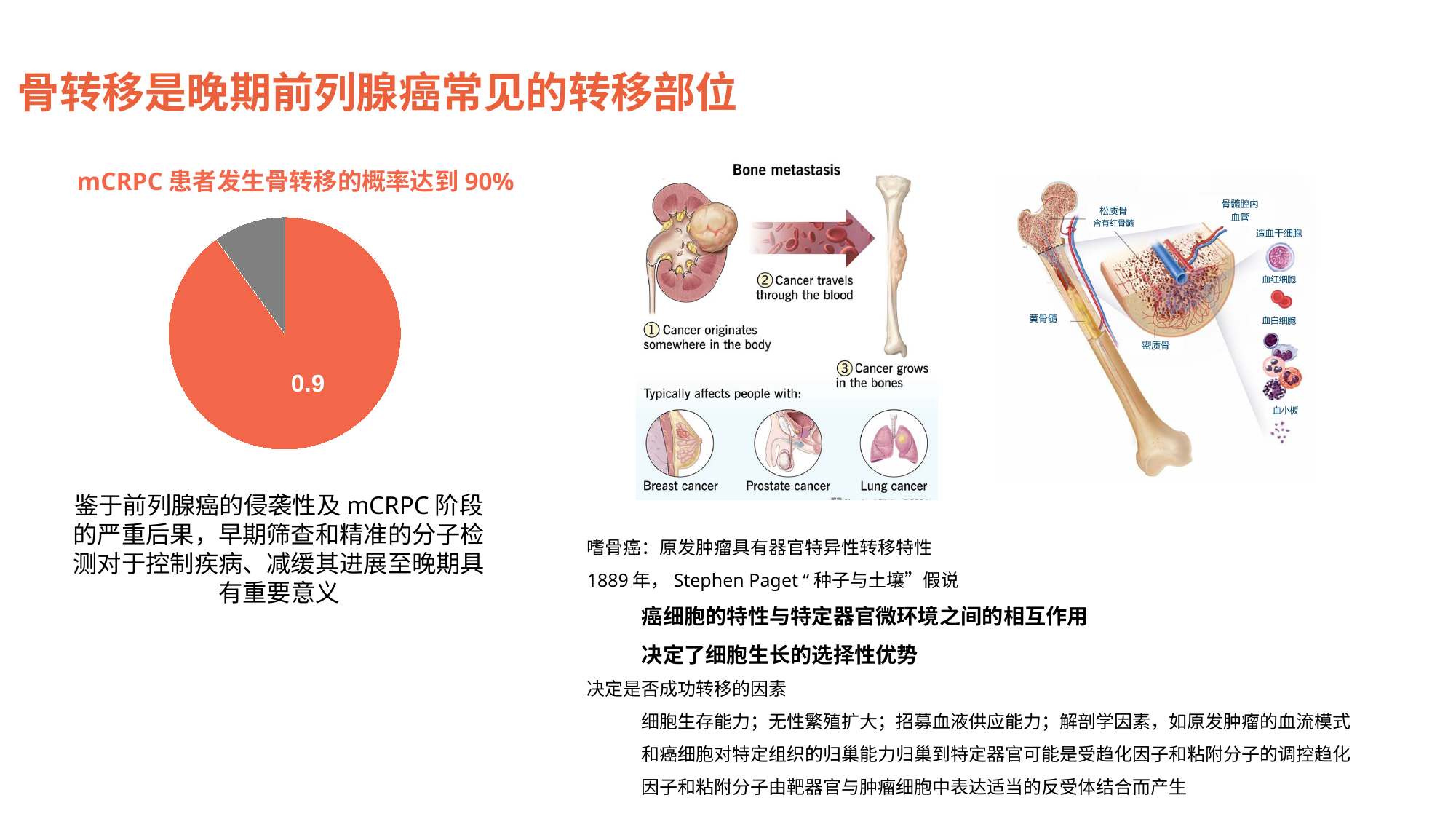
What share of the pie does the orange slice represent, according to its data label? 0.9 What value is printed on the orange slice of the pie chart? 0.9 Which slice of the pie chart is larger, the orange one or the gray one? the orange one How many slices does the pie chart have? 2 What is the title printed above the pie chart? mCRPC 患者发生骨转移的概率达到 90% What colour is the smaller slice of the pie chart? gray What kind of chart is shown on the left of the slide? pie chart